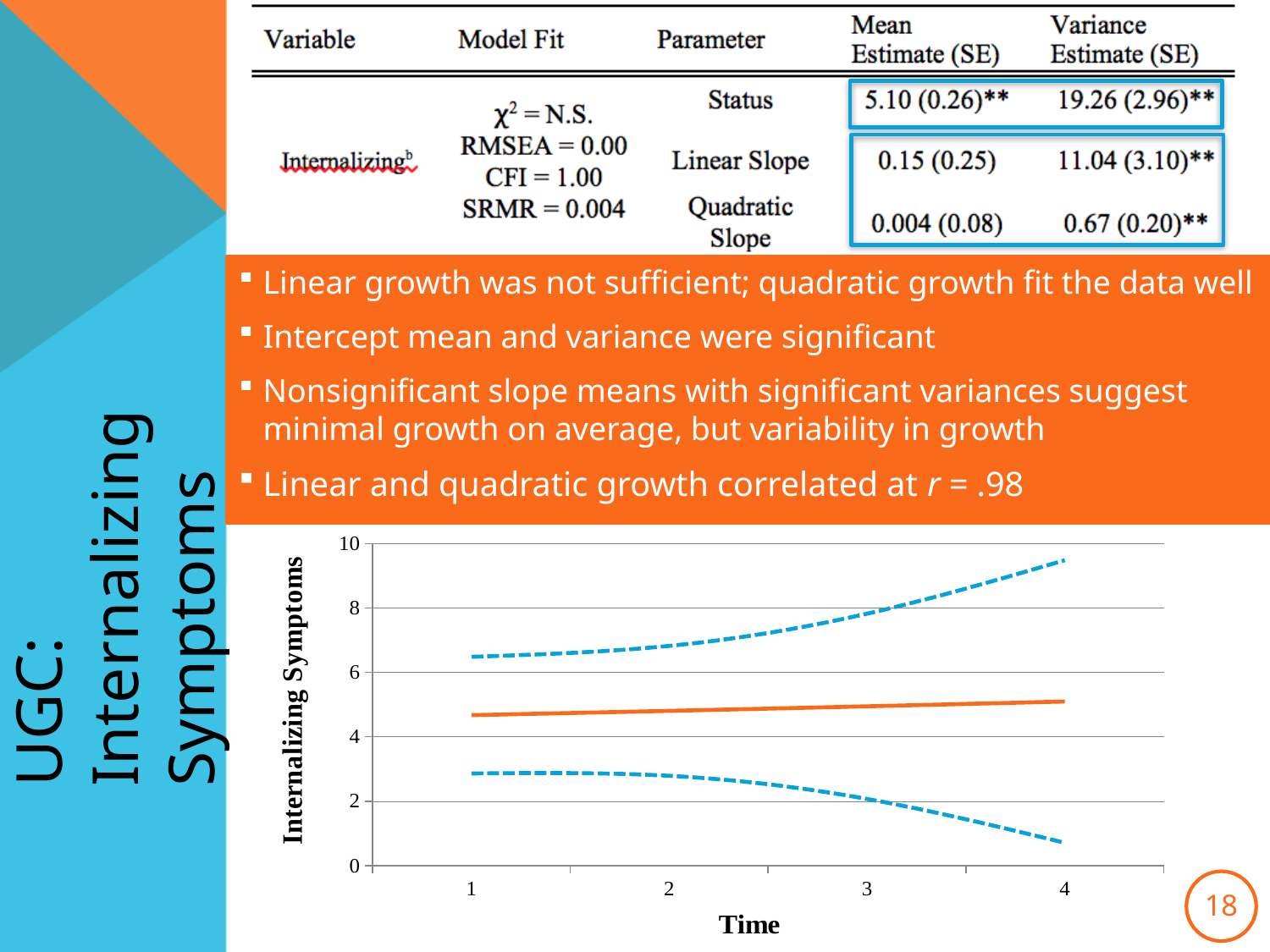
What kind of chart is shown at the bottom of the slide? line chart Is the value of the upper dashed line at Time 1 greater or less than 6? greater How many time points are shown on the x axis of the chart? 4 How many lines are plotted on the chart? 3 Is the value of the solid orange line at Time 1 greater or less than 4? greater Is the value of the upper dashed line at Time 4 greater or less than 8? greater At Time 4, which line has the highest value: the upper dashed line, the solid line, or the lower dashed line? the upper dashed line Does the lower dashed line rise or fall from Time 1 to Time 4? fall What is the title of the x axis of the chart? Time Does the upper dashed line rise or fall from Time 1 to Time 4? rise What is the title of the y axis of the chart? Internalizing Symptoms